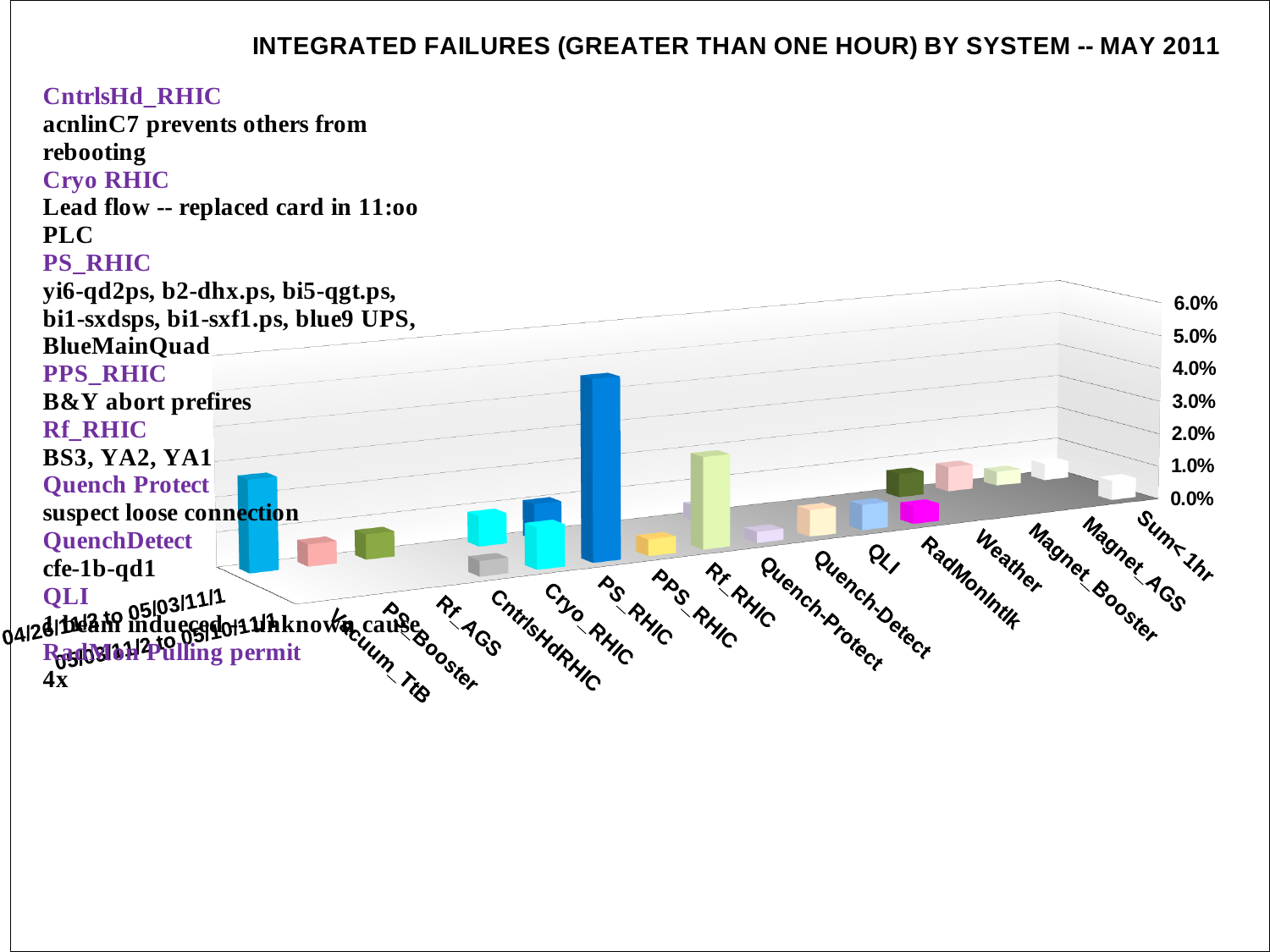
How many system categories are shown along the x axis of the chart? 16 Which is larger, the value for Rf_RHIC or the value for PPS_RHIC? Rf_RHIC What is the title of the chart? INTEGRATED FAILURES (GREATER THAN ONE HOUR) BY SYSTEM -- MAY 2011 Is the value for Vacuum_TtB greater or less than 1.0%? greater What is the highest tick value shown on the vertical axis of the chart? 6.0% What type of chart is shown on the slide? bar chart What is the label of the last category on the x axis of the chart? Sum< 1hr Which is larger, the value for Vacuum_TtB or the value for PS_Booster? Vacuum_TtB Is the value for PS_Booster greater or less than 1.0%? less Which system has the highest bar in the chart? PS_RHIC